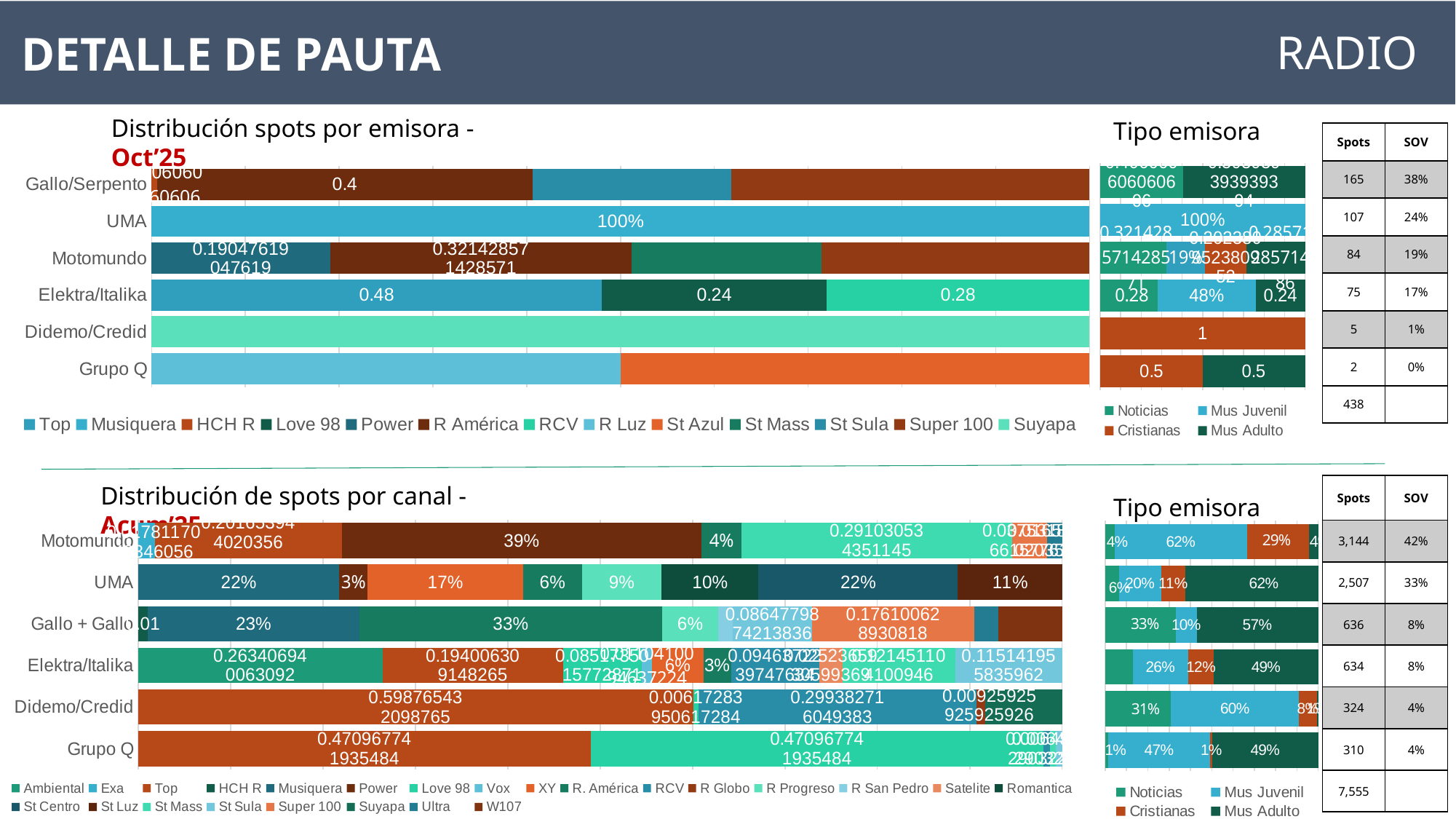
What kind of chart is the 'Distribución spots por emisora - Oct'25' chart? bar chart In the 'Distribución spots por emisora - Oct'25' chart, what value is labelled on the UMA bar? 100% How many series does the legend of the top 'Tipo emisora' chart list? 4 In the top 'Tipo emisora' chart, what value is labelled on the Didemo/Credid bar? 1 In the 'Distribución de spots por canal - Acum'25' chart, what is the difference between the 39% and 4% labelled segments of Motomundo? 35% In the 'Distribución spots por emisora - Oct'25' chart, what is the largest labelled segment value for Elektra/Italika? 0.48 In the bottom 'Tipo emisora' chart, what is the Mus Adulto value for Gallo + Gallo? 57% How many categories (emisoras) are shown on the 'Distribución spots por emisora - Oct'25' chart? 6 In the 'Distribución de spots por canal - Acum'25' chart, what is the largest labelled segment value for UMA? 22% How many series does the legend of the 'Distribución spots por emisora - Oct'25' chart list? 13 In the top 'Tipo emisora' chart, what are the two labelled values for Grupo Q? 0.5 and 0.5 In the bottom 'Tipo emisora' chart, which is larger for Didemo/Credid: Noticias or Mus Juvenil? Mus Juvenil